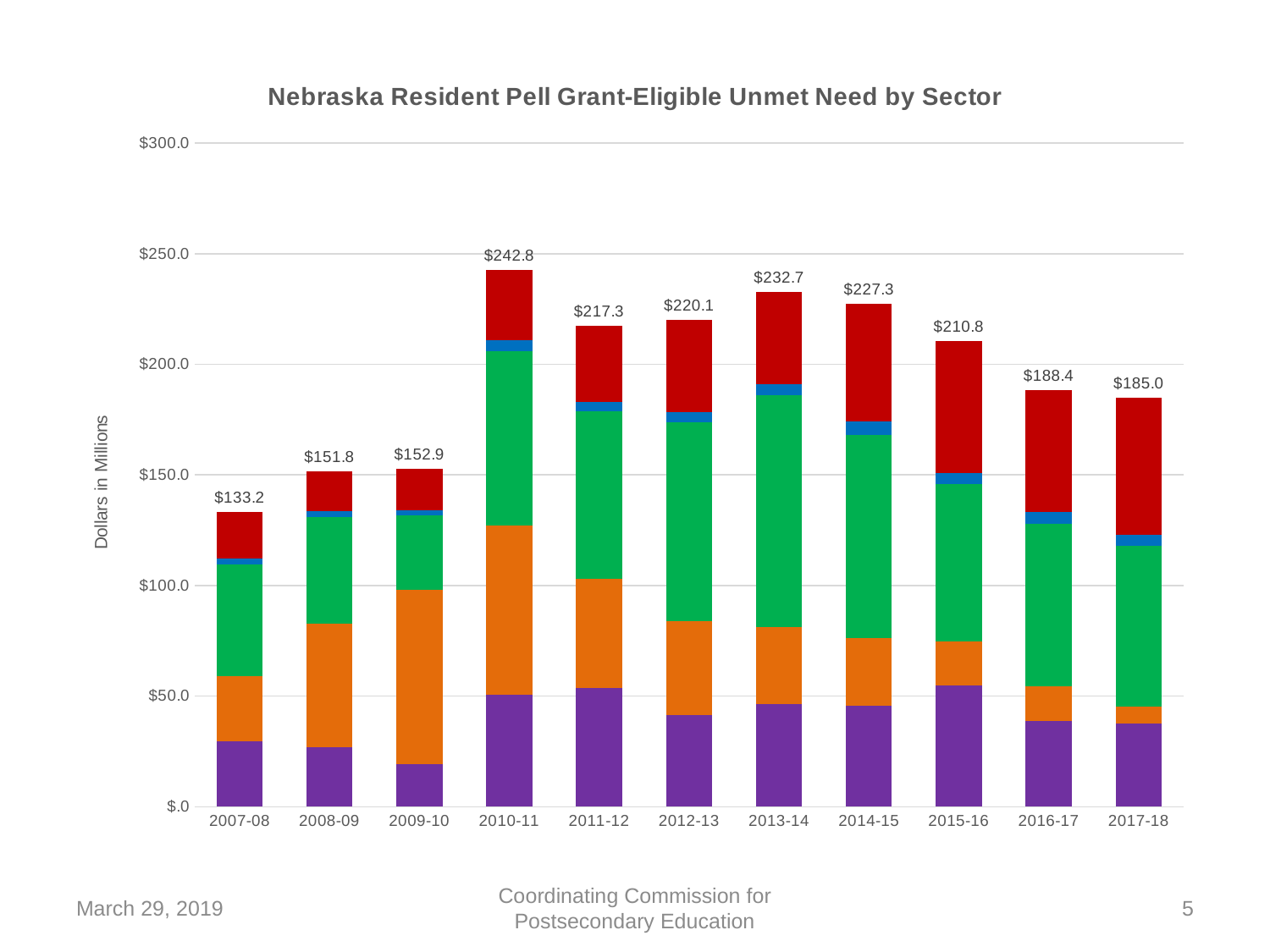
What kind of chart is shown on the slide? Stacked bar chart Which year has the larger total, 2008-09 or 2009-10? 2009-10 Is the purple segment for 2009-10 greater or less than $50.0? less Which year has the lowest total unmet need? 2007-08 Do the total values rise or fall from 2013-14 to 2017-18? Fall What is the total value labeled for 2007-08? $133.2 What is the difference between the totals for 2010-11 and 2007-08? $109.6 What is the total value labeled for 2017-18? $185.0 What is the total unmet need shown for 2010-11? $242.8 What is the difference between the totals for 2013-14 and 2014-15? $5.4 Which year has the highest total unmet need? 2010-11 How many academic years are shown on the x axis? 11